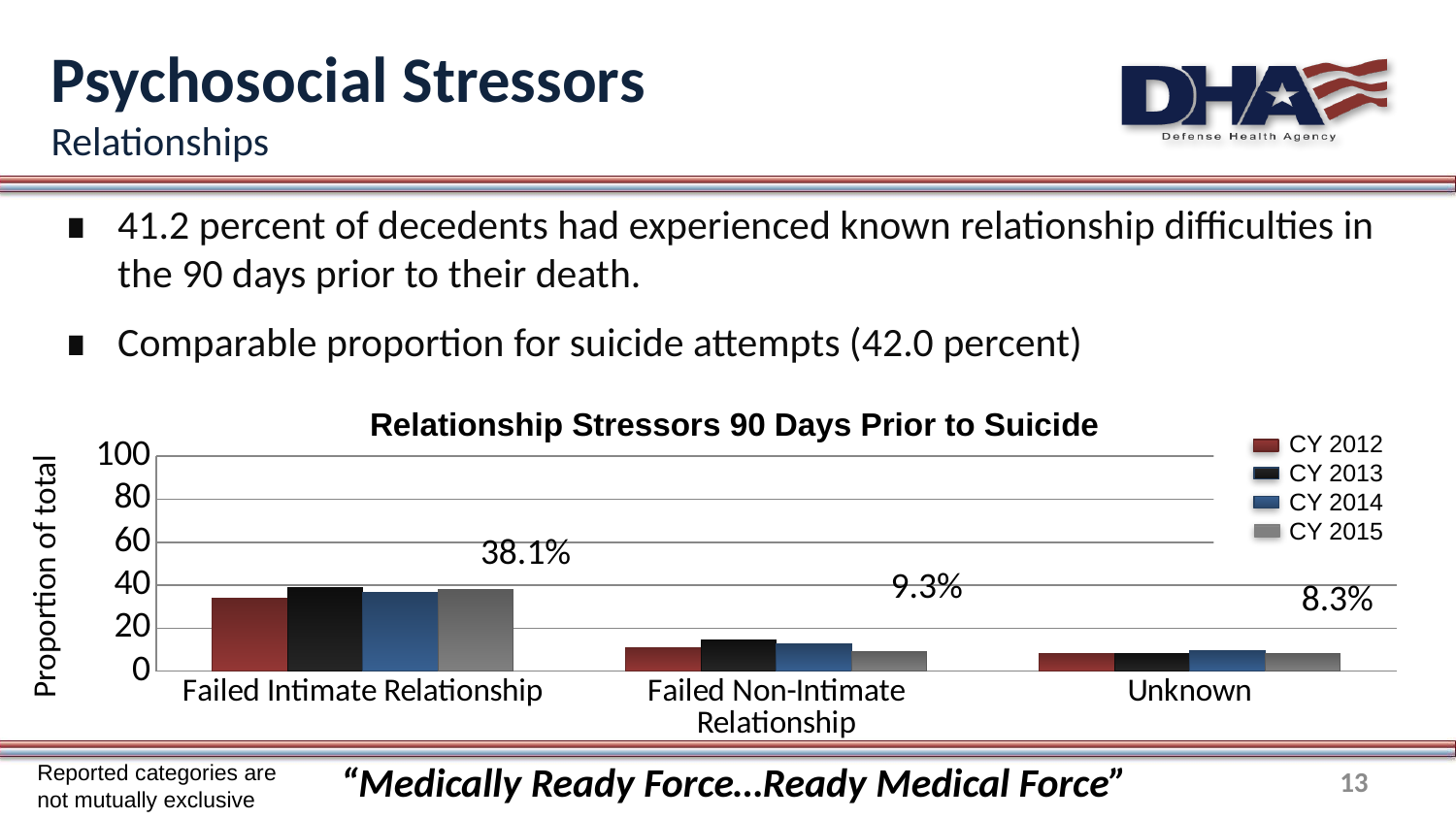
Which category has the highest bars overall? Failed Intimate Relationship How many categories are shown on the x axis of the chart? 3 What is the label of the y axis? Proportion of total What data label is shown for the Failed Intimate Relationship group? 38.1% What data label is shown for the Failed Non-Intimate Relationship group? 9.3% What is the title of the chart? Relationship Stressors 90 Days Prior to Suicide What is the difference between the labelled values for Failed Intimate Relationship (38.1%) and Failed Non-Intimate Relationship (9.3%)? 28.8% What data label is shown for the Unknown group? 8.3% Within the Failed Intimate Relationship group, which series has the lowest bar? CY 2012 How many series does the chart legend list? 4 Is the CY 2012 value for Failed Intimate Relationship greater or less than 40? less What type of chart is shown on the slide? bar chart